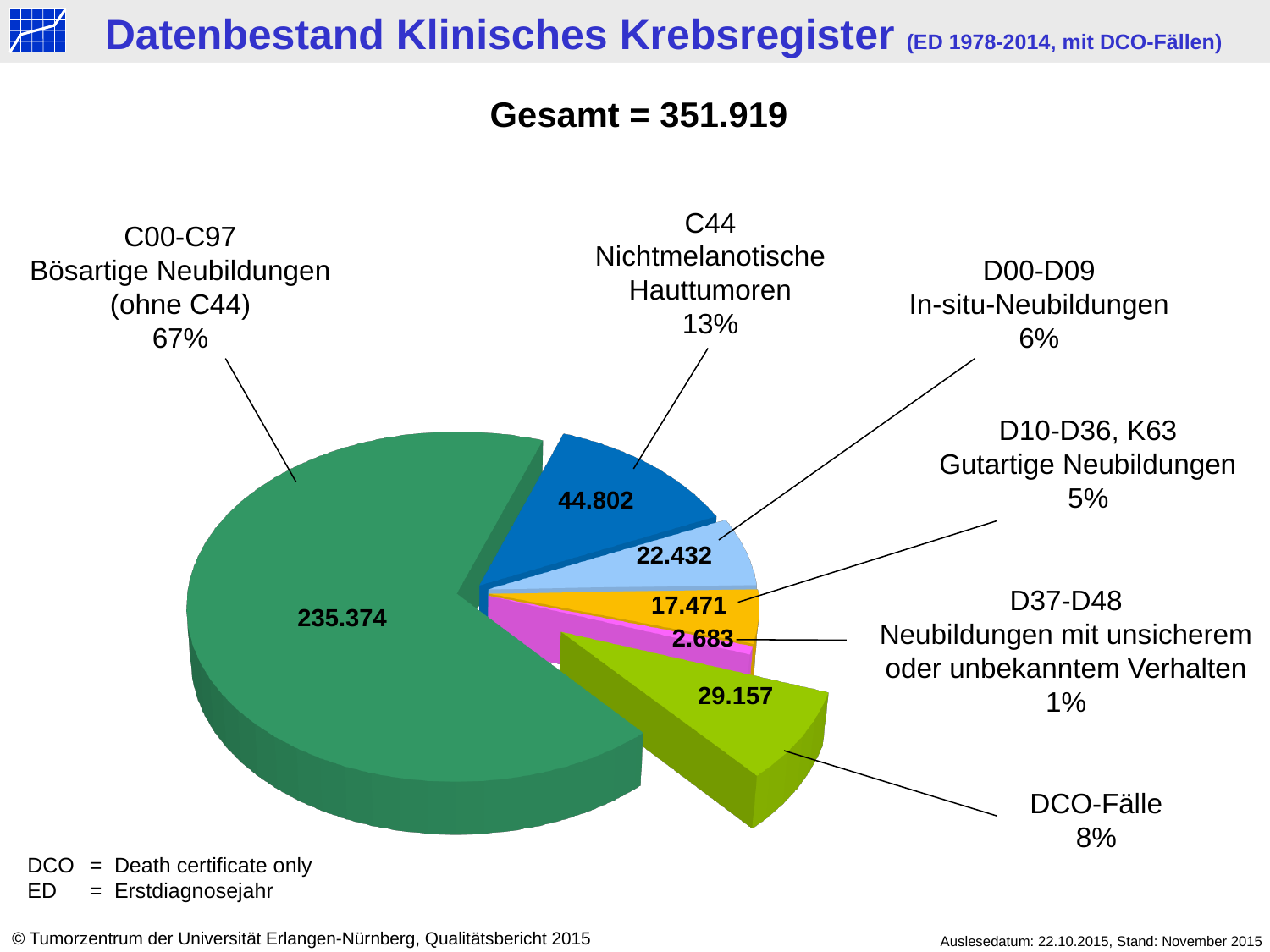
What total is stated above the pie chart? Gesamt = 351.919 Which category has the smallest slice? D37-D48 Neubildungen mit unsicherem oder unbekanntem Verhalten Which is larger, the value for DCO-Fälle or the value for D10-D36, K63 Gutartige Neubildungen? DCO-Fälle What is the difference between the values for C44 Nichtmelanotische Hauttumoren and D00-D09 In-situ-Neubildungen? 22.370 What type of chart is shown on the slide? pie chart What share of the pie do D00-D09 In-situ-Neubildungen represent? 6% Which category has the largest slice? C00-C97 Bösartige Neubildungen (ohne C44) What share of the pie do D37-D48 Neubildungen mit unsicherem oder unbekanntem Verhalten represent? 1% How many slices does the pie chart have? 6 What is the value for DCO-Fälle? 29.157 What is the value for C00-C97 Bösartige Neubildungen (ohne C44)? 235.374 What is the value for C44 Nichtmelanotische Hauttumoren? 44.802